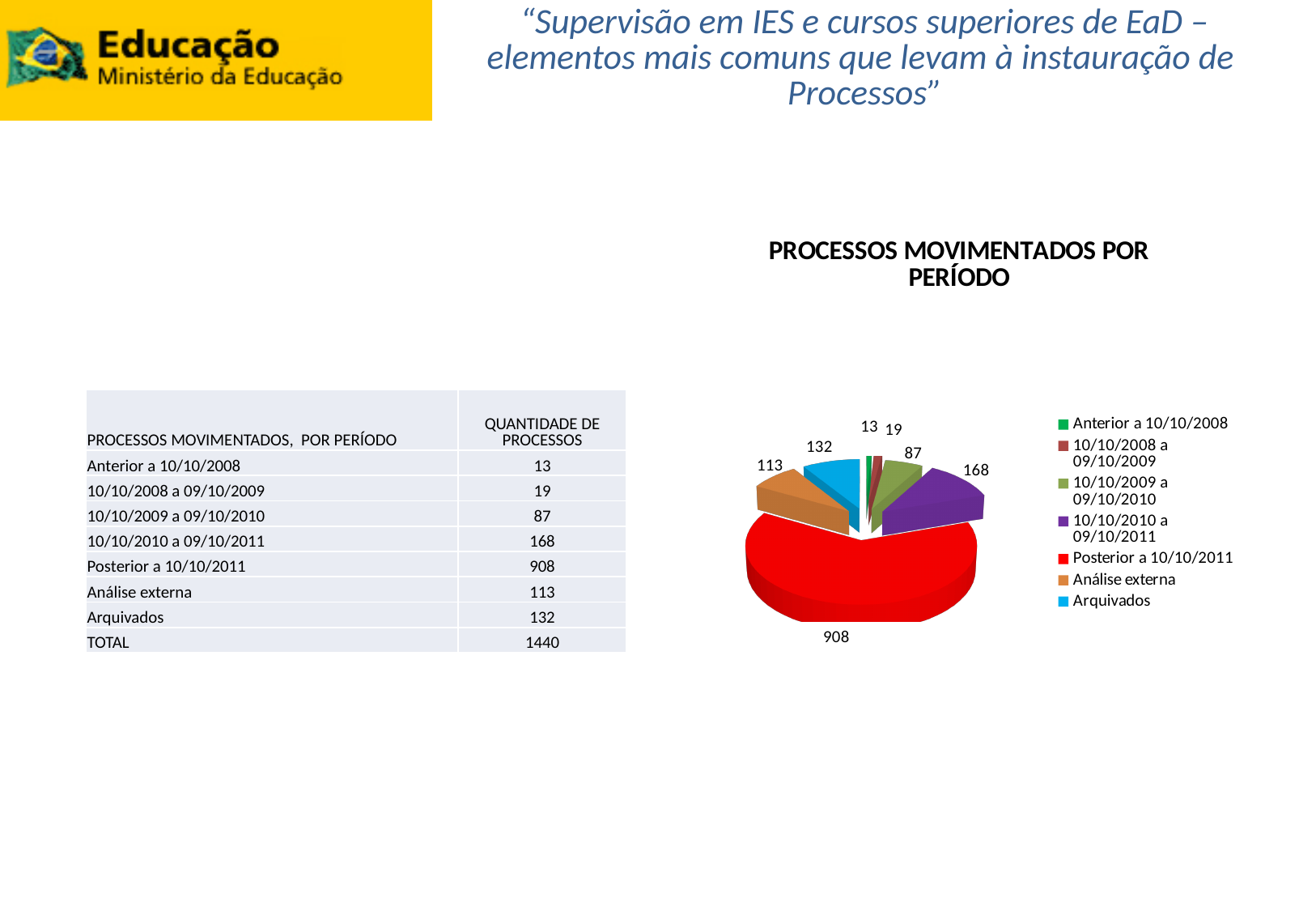
What colour is the slice for Posterior a 10/10/2011? red What is the difference between the values for 10/10/2010 a 09/10/2011 and 10/10/2009 a 09/10/2010? 81 What is the difference between the values for Arquivados and Análise externa? 19 What is the value for 10/10/2010 a 09/10/2011 in the pie chart? 168 Which is larger, the value for Arquivados or the value for Análise externa? Arquivados Which category has the largest slice in the pie chart? Posterior a 10/10/2011 What is the value for Análise externa in the pie chart? 113 What is the total of all the slice values in the pie chart? 1440 Which category has the smallest slice in the pie chart? Anterior a 10/10/2008 What is the value for Posterior a 10/10/2011 in the pie chart? 908 How many slices does the pie chart have? 7 What kind of chart is shown on the slide? pie chart